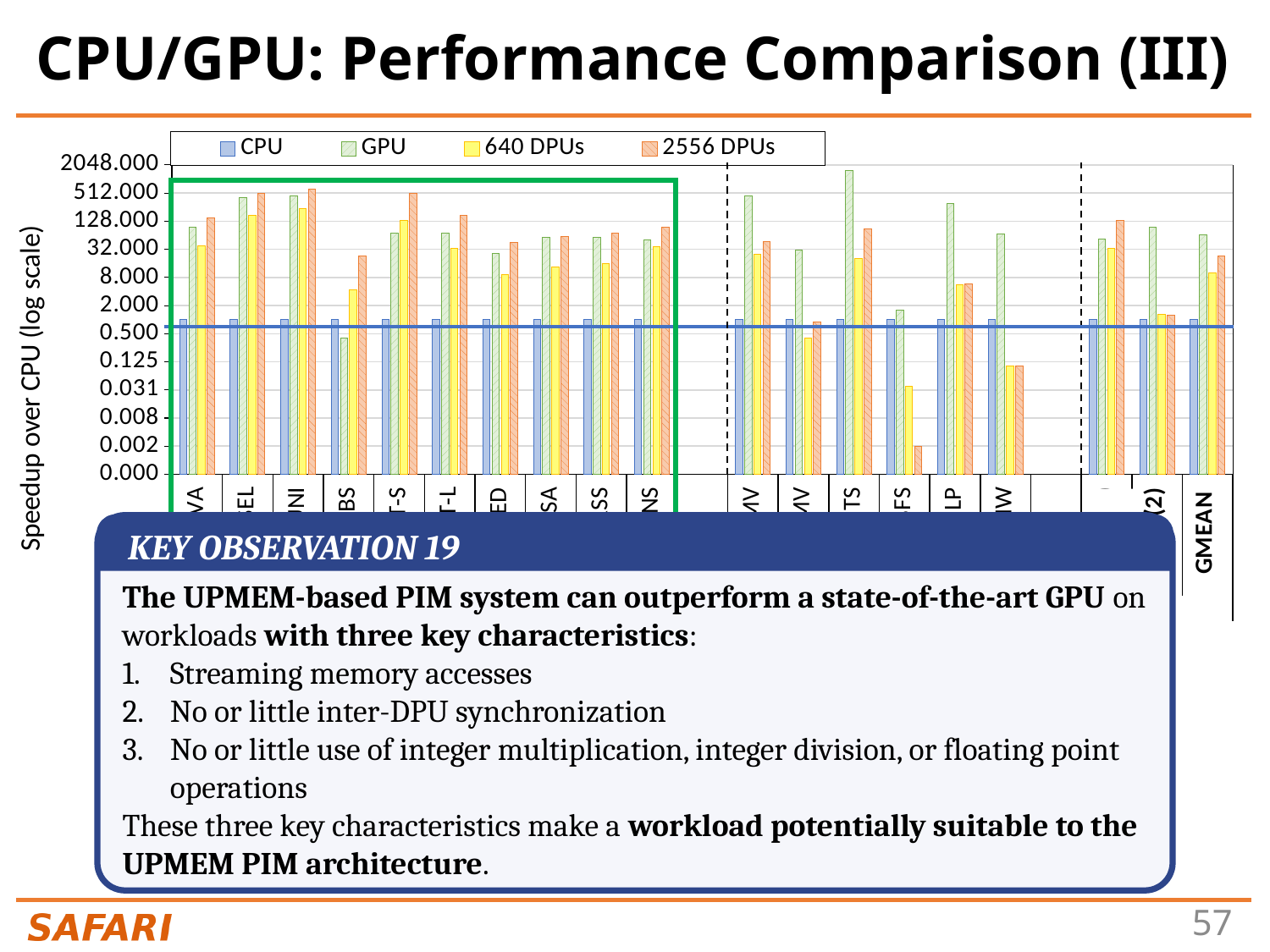
Which series has the highest value for GMEAN? GPU Is the GPU value for LP greater or less than 128.000? greater What kind of chart is shown on the slide? bar chart What is the label of the chart's vertical axis? Speedup over CPU (log scale) For GMEAN, which is larger: the 2556 DPUs value or the 640 DPUs value? 2556 DPUs What are the series names listed in the chart's legend? CPU, GPU, 640 DPUs, 2556 DPUs For GMEAN, which is larger: the GPU value or the 640 DPUs value? GPU Is the 640 DPUs value for GMEAN greater or less than 2.000? greater Is the GPU value for BS greater or less than 2.000? less How many series does the chart's legend list? 4